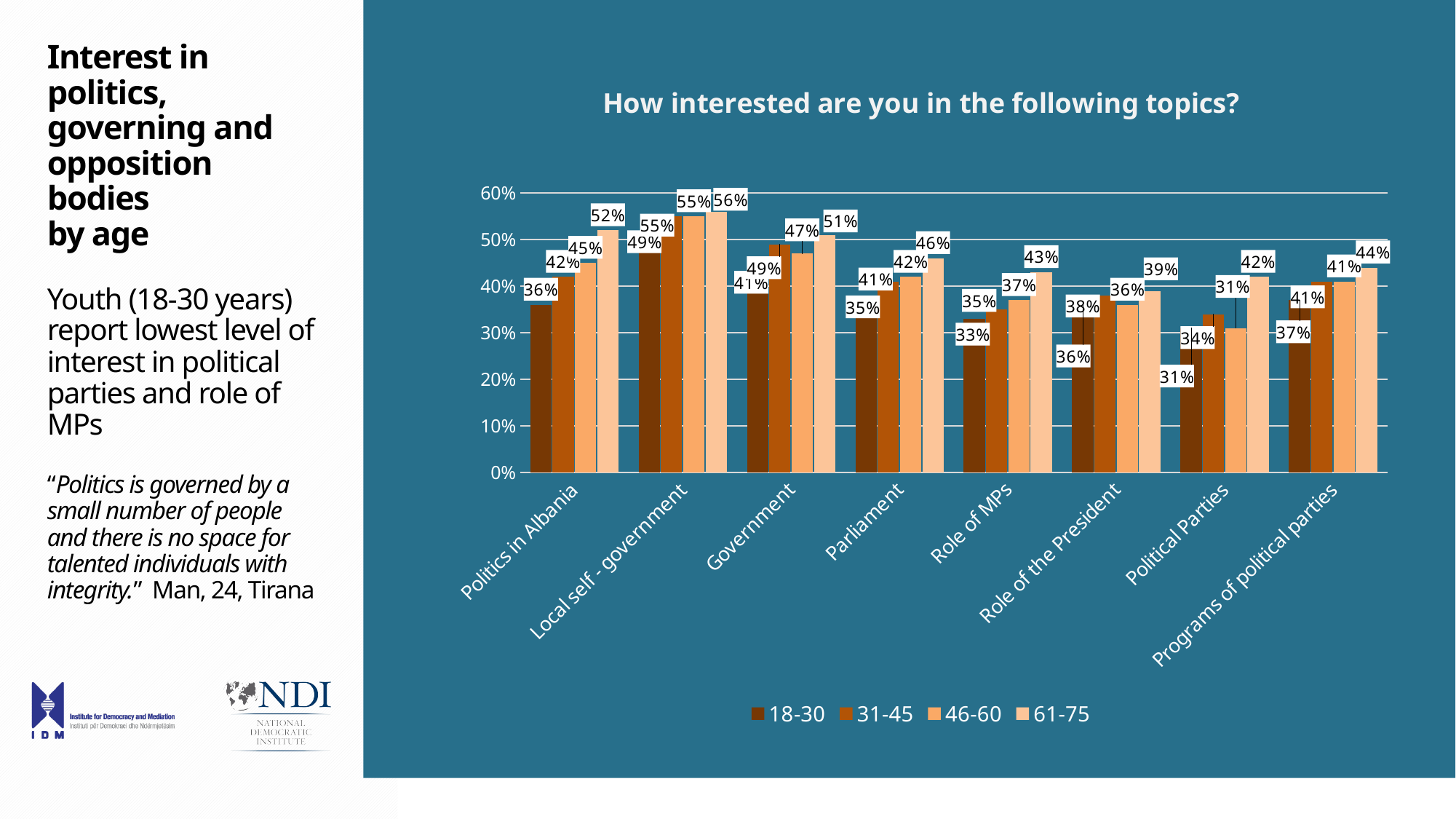
For the 61-75 age group, which is larger: Government or Parliament? Government What is the difference between the 61-75 and 18-30 values for Politics in Albania? 16 percentage points What is the value for the 61-75 age group for Politics in Albania? 52% How many topics are shown on the x axis? 8 Which topic has the highest value for the 61-75 age group? Local self - government What is the value for the 18-30 age group for Role of MPs? 33% What is the value for the 61-75 age group for Political Parties? 42% How many age groups does the legend list? 4 What is the value for the 18-30 age group for Politics in Albania? 36% Which topic has the lowest value for the 18-30 age group? Political Parties Is the value for the 18-30 age group for Local self - government greater or less than 40%? greater What kind of chart is shown on the slide? Bar chart